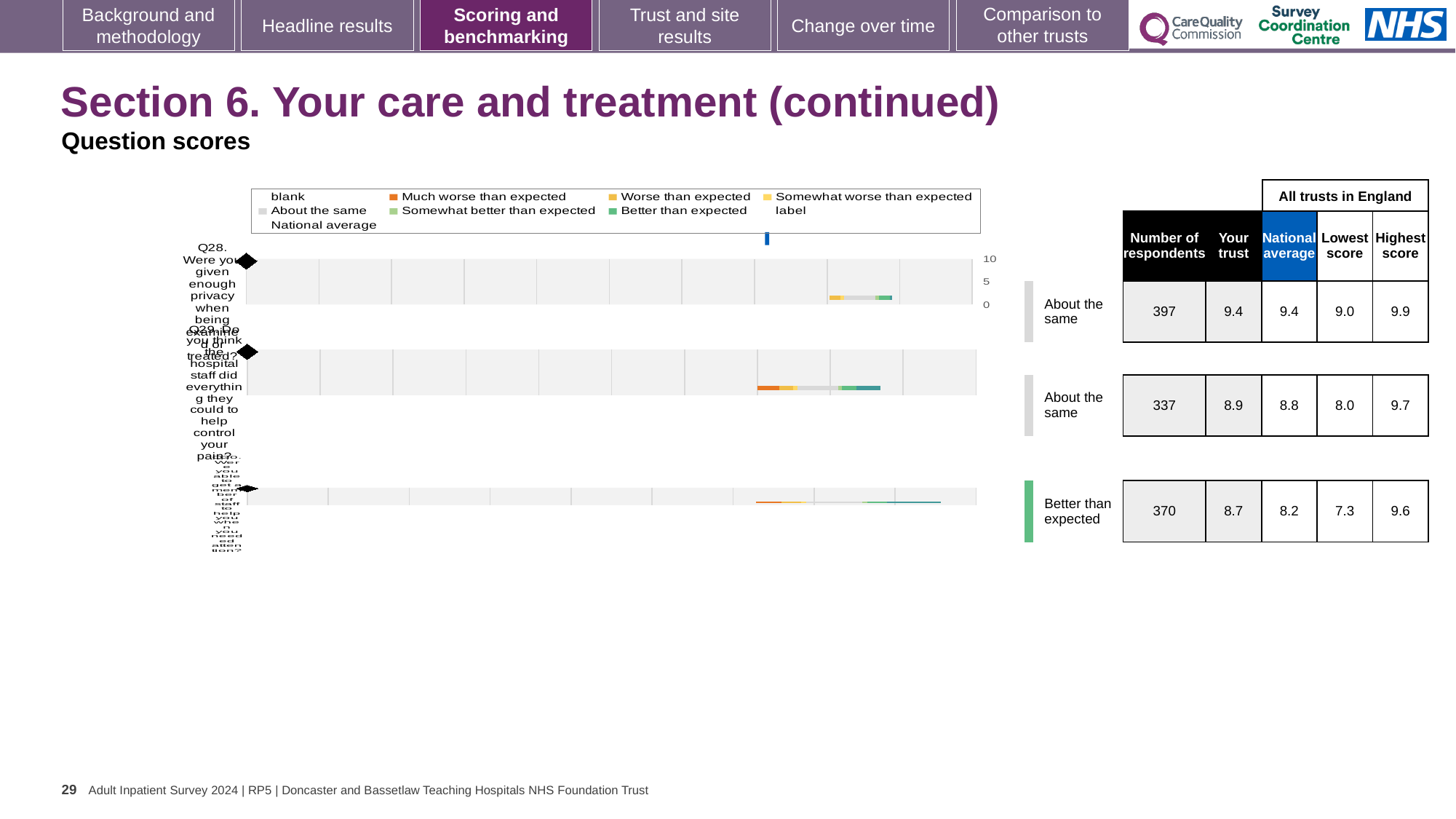
How many survey questions are plotted in the chart? 3 What benchmark category is shown for Q30? Better than expected How many respondents are listed for Q28? 397 What is the 'Your trust' score for Q28 (privacy when being examined or treated)? 9.4 What is the difference between the highest and lowest scores for Q29? 1.7 Which question has the largest number of respondents? Q28 Which has the higher 'Your trust' score, Q28 or Q29? Q28 What kind of chart is shown on the slide? bar chart What is the national average score for Q29 (hospital staff helping to control pain)? 8.8 What benchmark category is shown for Q28? About the same What is the difference between the 'Your trust' score and the national average for Q30? 0.5 What is the highest score among all trusts in England for Q30? 9.6